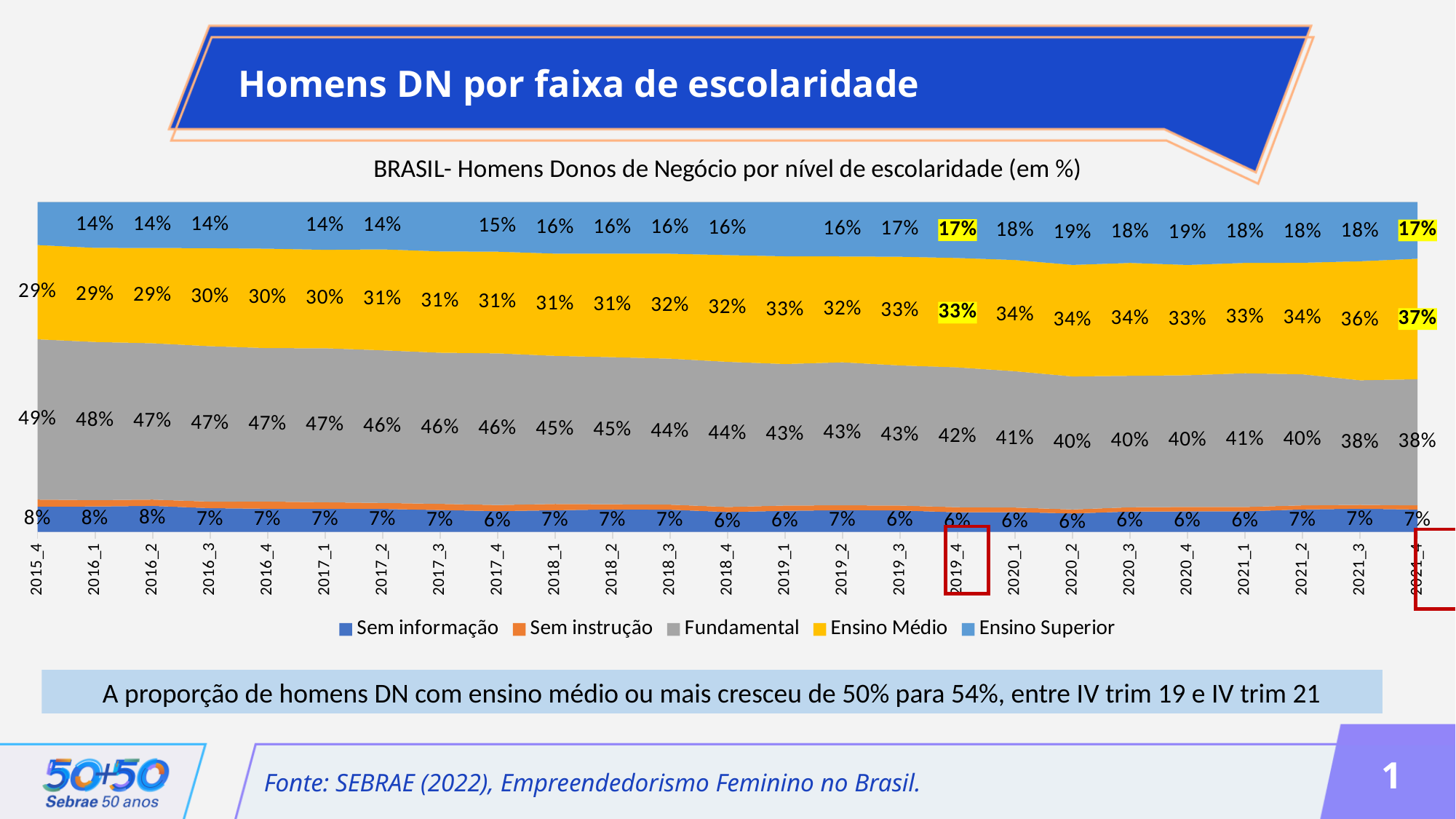
By how many percentage points did Ensino Médio change from 2019_4 to 2021_4? 4 percentage points In which quarter is the Fundamental share highest? 2015_4 What is the value for Fundamental in 2015_4? 49% What is the value for Ensino Médio in 2021_4? 37% Does the Fundamental share rise or fall from 2015_4 to 2021_4? Fall What type of chart is shown on the slide? Stacked area chart What is the value for Ensino Superior in 2019_4? 17% How many series does the legend list? 5 How many quarters are plotted along the x axis? 25 What is the title of the chart? BRASIL- Homens Donos de Negócio por nível de escolaridade (em %) What is the difference between the Fundamental value in 2015_4 and in 2021_4? 11 percentage points What is the value for Sem informação in 2016_2? 8%